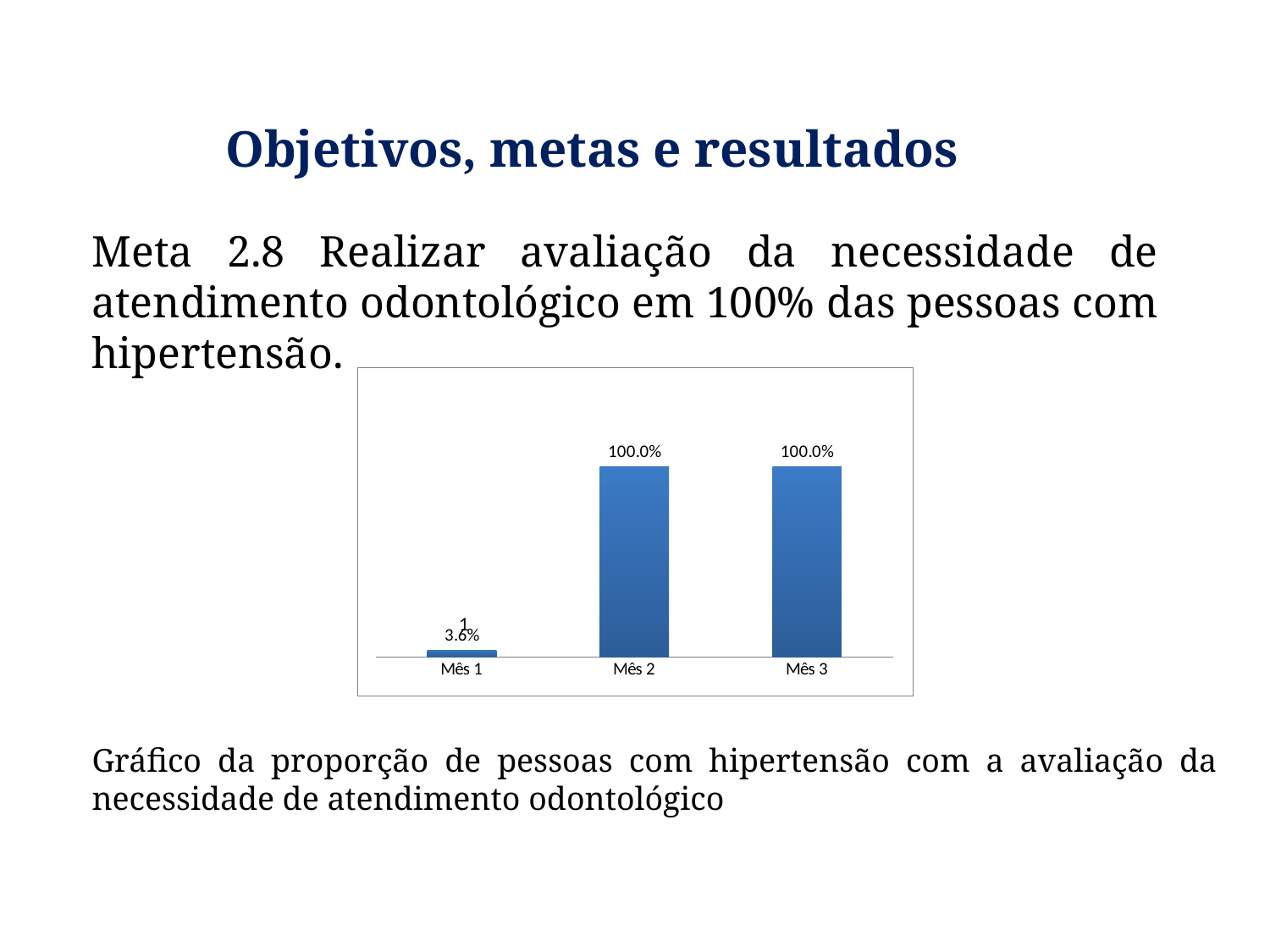
What is the difference between the values for Mês 2 and Mês 3? 0.0% What is the value for Mês 3? 100.0% What kind of chart is shown on the slide? bar chart What colour are the bars in the chart? blue How many months are shown on the x axis? 3 Do the values rise or fall from Mês 1 to Mês 2? rise Which month has the lowest value? Mês 1 What are the category labels on the x axis? Mês 1, Mês 2, Mês 3 What is the value for Mês 2? 100.0% Is the value for Mês 1 greater or less than 50%? less Which is larger, the value for Mês 1 or the value for Mês 2? Mês 2